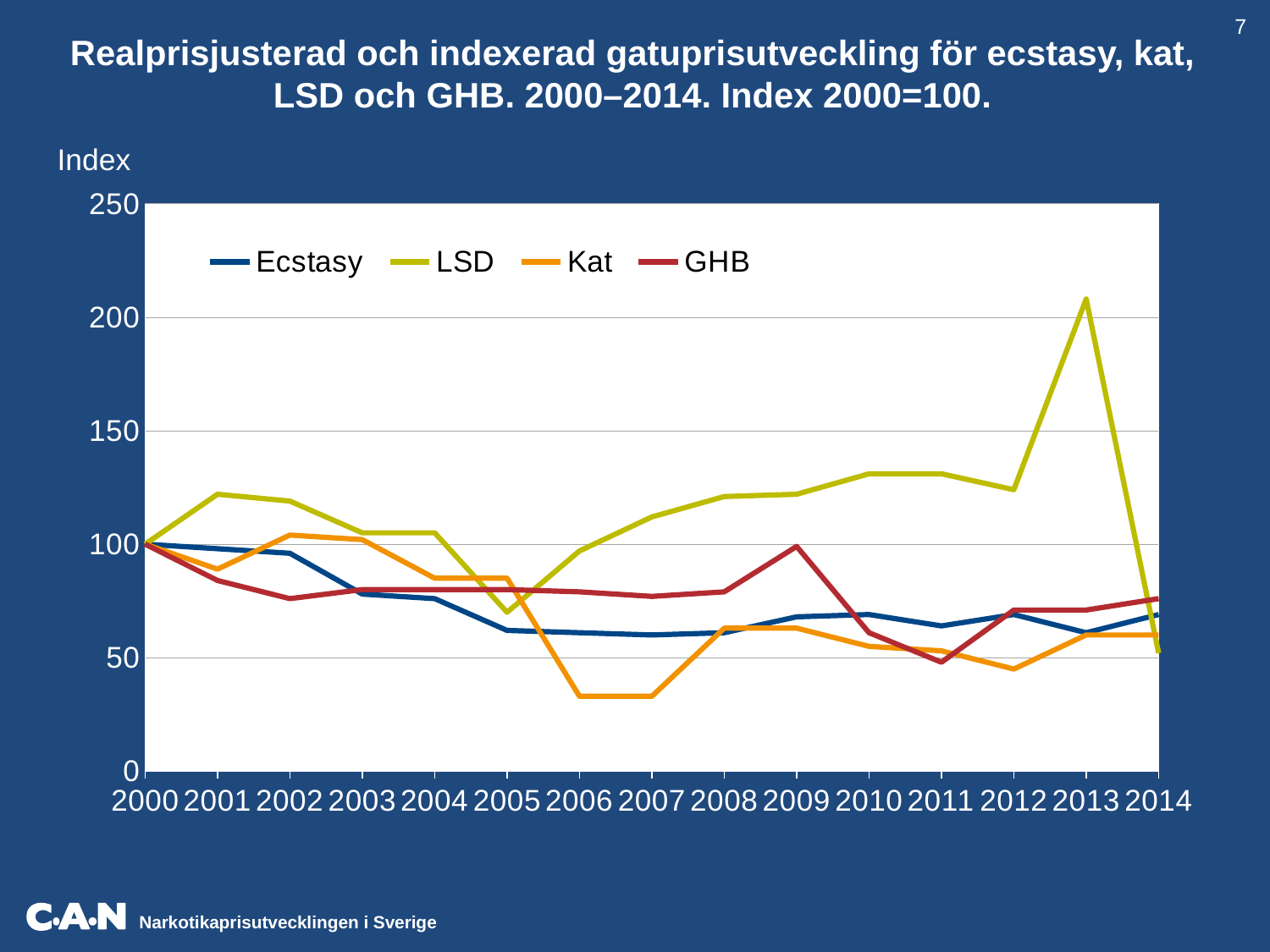
What kind of chart is shown on the slide? Line chart Which series has the highest value in 2013? LSD Does the LSD line rise or fall from 2013 to 2014? Fall How many series does the legend list? 4 How many years are shown along the x axis? 15 What is the index value for LSD in 2000? 100 Is the value for Ecstasy in 2005 greater or less than 100? less Which series has the lowest value in 2006? Kat Is the value for LSD in 2013 greater or less than 200? greater Is the value for Kat in 2006 greater or less than 50? less Which series is drawn in red? GHB Which is larger in 2010, the value for LSD or the value for Kat? LSD